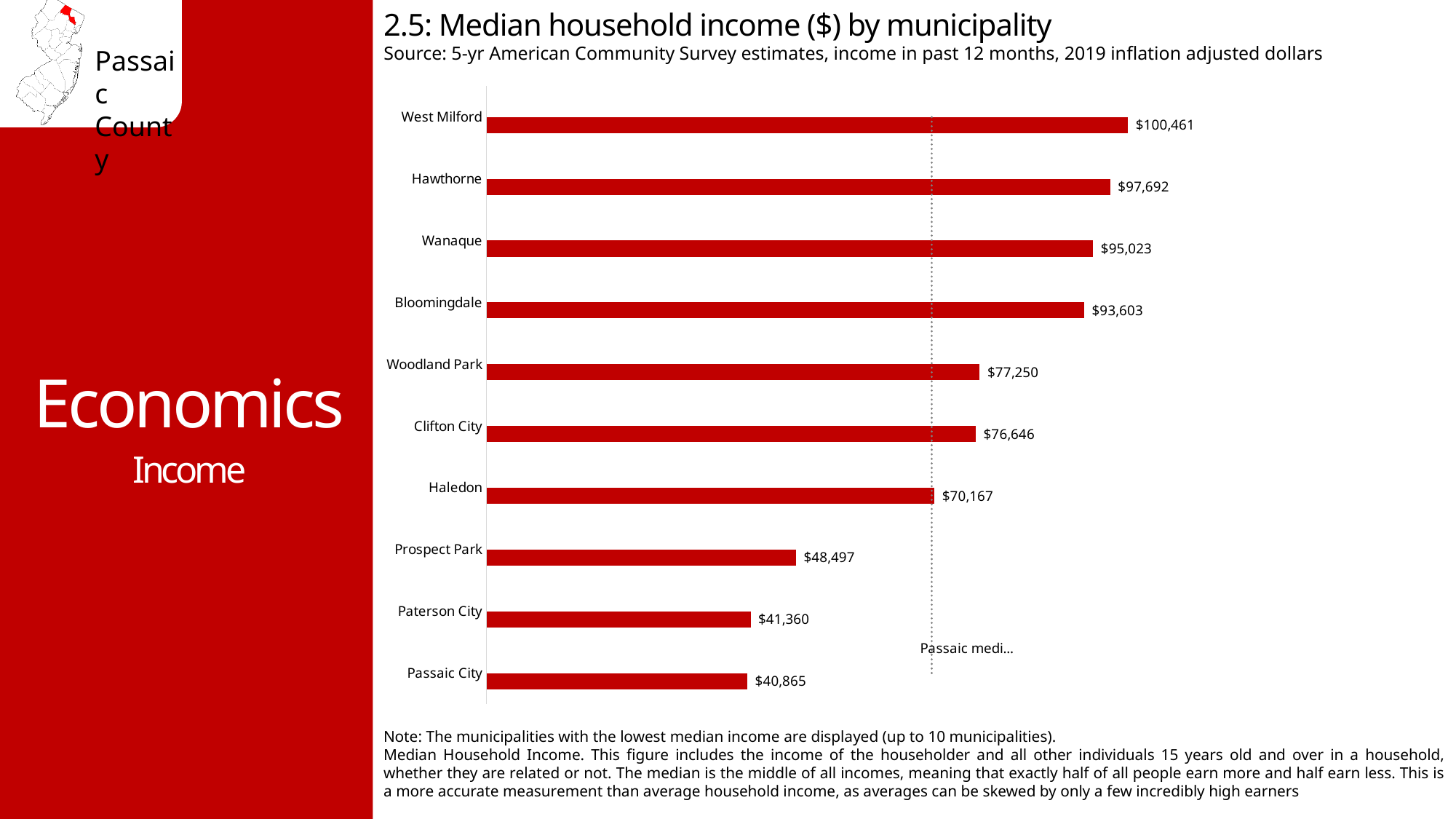
What is the difference in median household income between Hawthorne and Wanaque? $2,669 Which has a higher median household income, Bloomingdale or Woodland Park? Bloomingdale Which municipality has the highest median household income? West Milford What is the title of the chart? 2.5: Median household income ($) by municipality Which has a higher median household income, Clifton City or Prospect Park? Clifton City What is the median household income for Paterson City? $41,360 What is the median household income for West Milford? $100,461 Which municipality has the lowest median household income? Passaic City What is the difference in median household income between Prospect Park and Passaic City? $7,632 What kind of chart is used to show median household income by municipality? Bar chart What is the median household income for Haledon? $70,167 How many municipalities are shown in the chart? 10